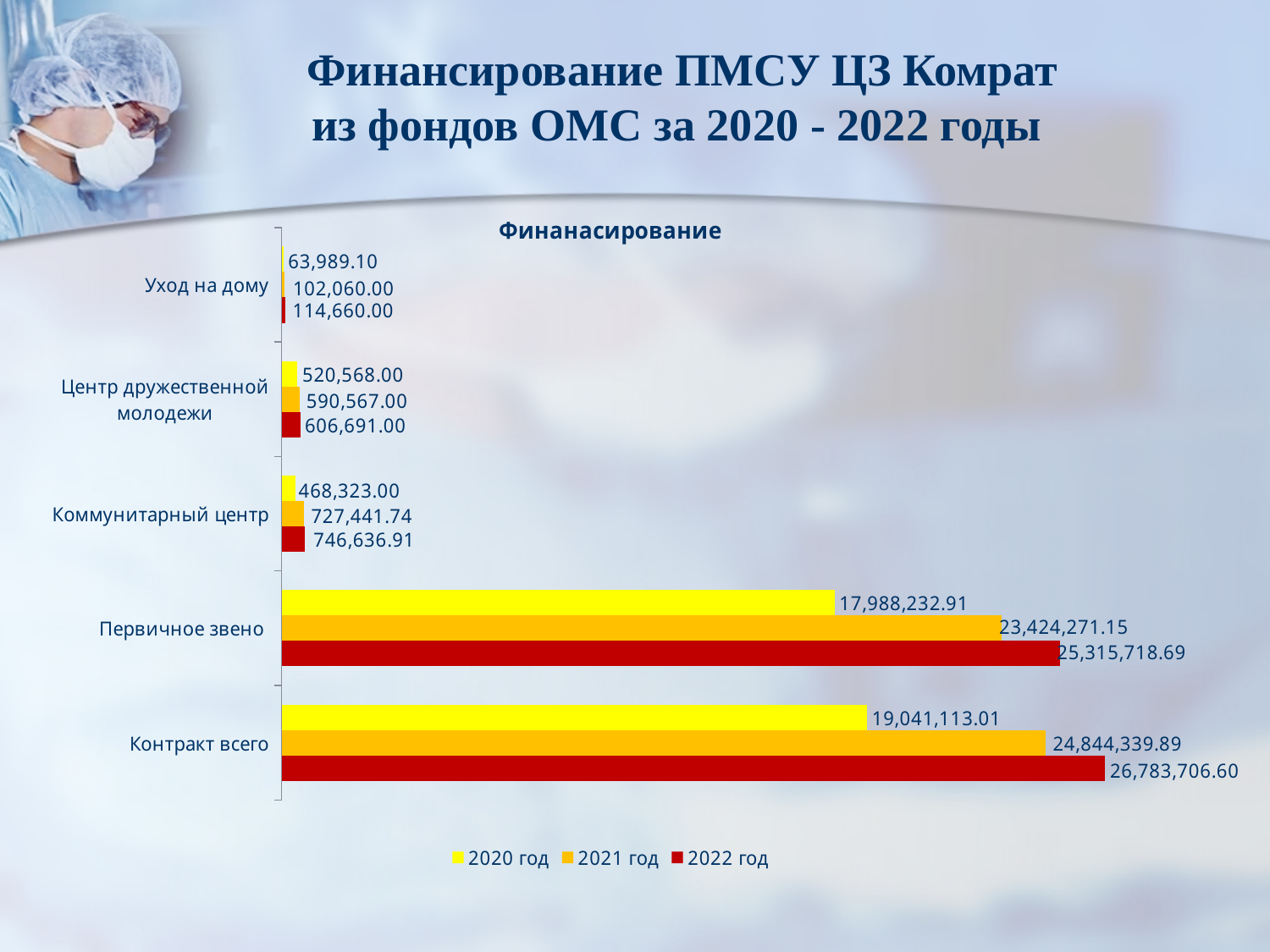
What is the value for Уход на дому in 2020 год? 63,989.10 What is the difference between the 2022 год and 2021 год values for Уход на дому? 12,600.00 What is the value for Контракт всего in 2022 год? 26,783,706.60 Which category has the lowest value for 2020 год? Уход на дому Which is larger for 2021 год: Коммунитарный центр or Центр дружественной молодежи? Коммунитарный центр How many categories are shown on the chart? 5 Which category has the highest value for 2022 год? Контракт всего How many series does the legend list? 3 What is the value for Коммунитарный центр in 2021 год? 727,441.74 What is the difference between the 2022 год and 2020 год values for Контракт всего? 7,742,593.59 What is the value for Первичное звено in 2021 год? 23,424,271.15 What kind of chart is shown on the slide? Bar chart